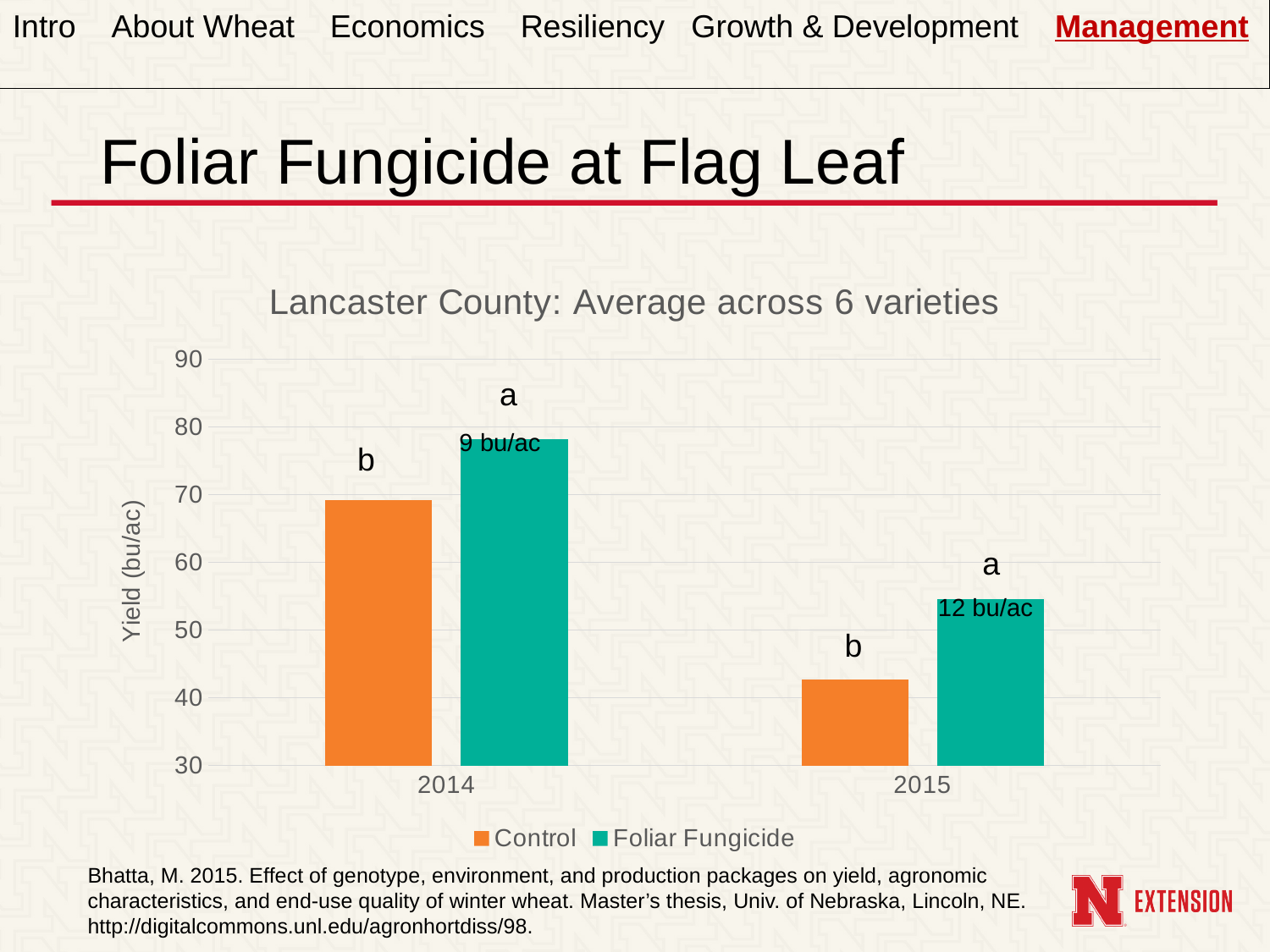
What is the title of the chart? Lancaster County: Average across 6 varieties Which bar is the lowest in the chart? Control in 2015 How many series does the legend list? 2 In 2014, which is larger, Control or Foliar Fungicide? Foliar Fungicide How many years are shown on the x axis? 2 What yield advantage is labeled for Foliar Fungicide over Control in 2015? 12 bu/ac What kind of chart is shown on the slide? bar chart Is the Control value for 2014 greater or less than 60? greater Which bar is the highest in the chart? Foliar Fungicide in 2014 Is the Foliar Fungicide value for 2015 greater or less than 60? less Does the Control yield rise or fall from 2014 to 2015? fall What is the label of the y axis? Yield (bu/ac)